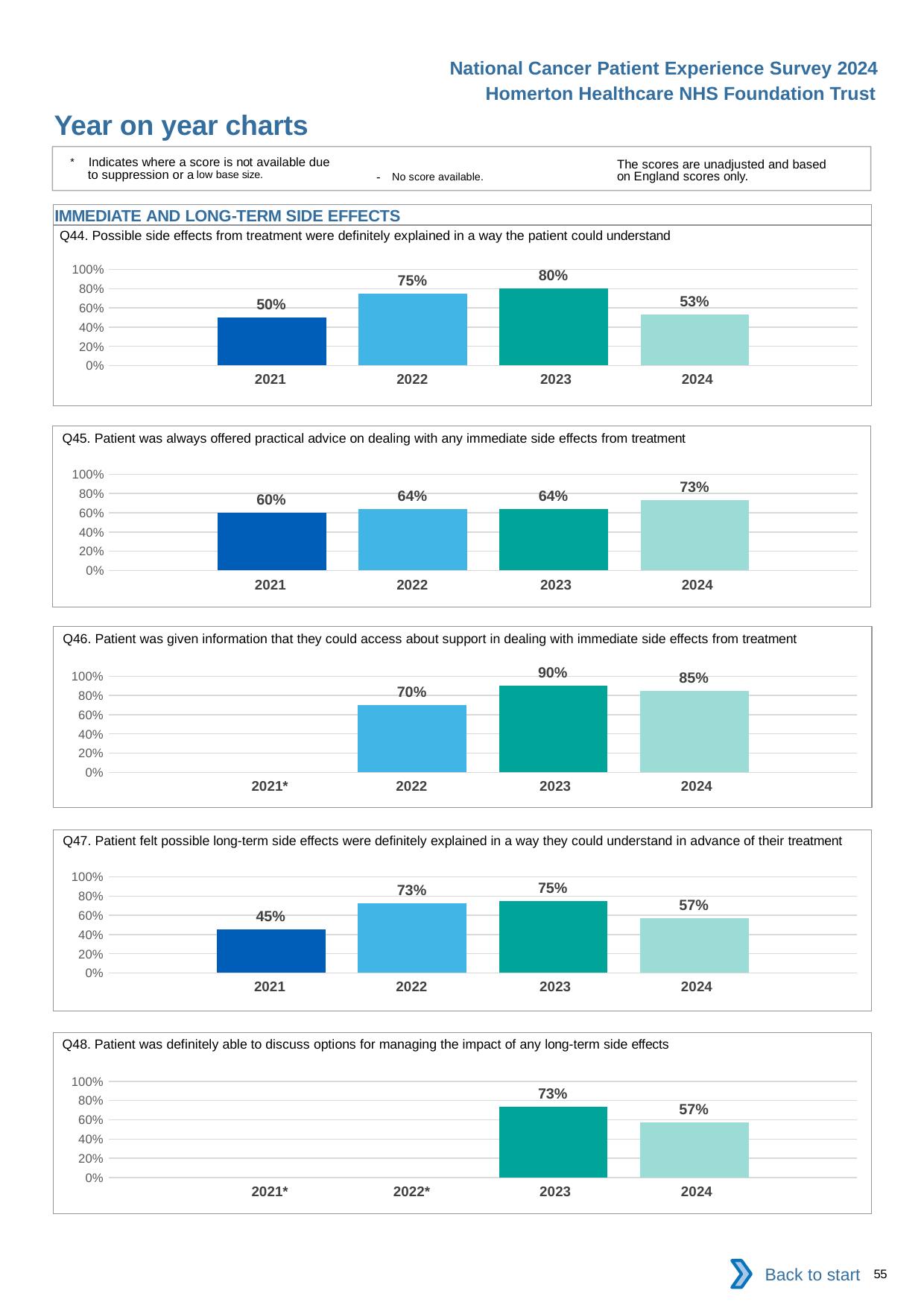
In the Q46 chart, how many years have a bar plotted? 3 In the Q48 chart, what is the value for 2024? 57% In the Q46 chart, which is larger, the value for 2023 or the value for 2024? 2023 In the Q44 chart, which year has the lowest value? 2021 In the Q48 chart, how many years have a bar plotted? 2 In the Q45 chart, which year has the highest value? 2024 In the Q47 chart, what is the difference between the 2023 value and the 2024 value? 18% In the Q46 chart, what is the value for 2022? 70% In the Q44 chart, what is the value for 2023? 80% In the Q45 chart, what is the difference between the 2024 value and the 2021 value? 13% In the Q47 chart, what is the value for 2021? 45% What type of chart is used for Q44? Bar chart